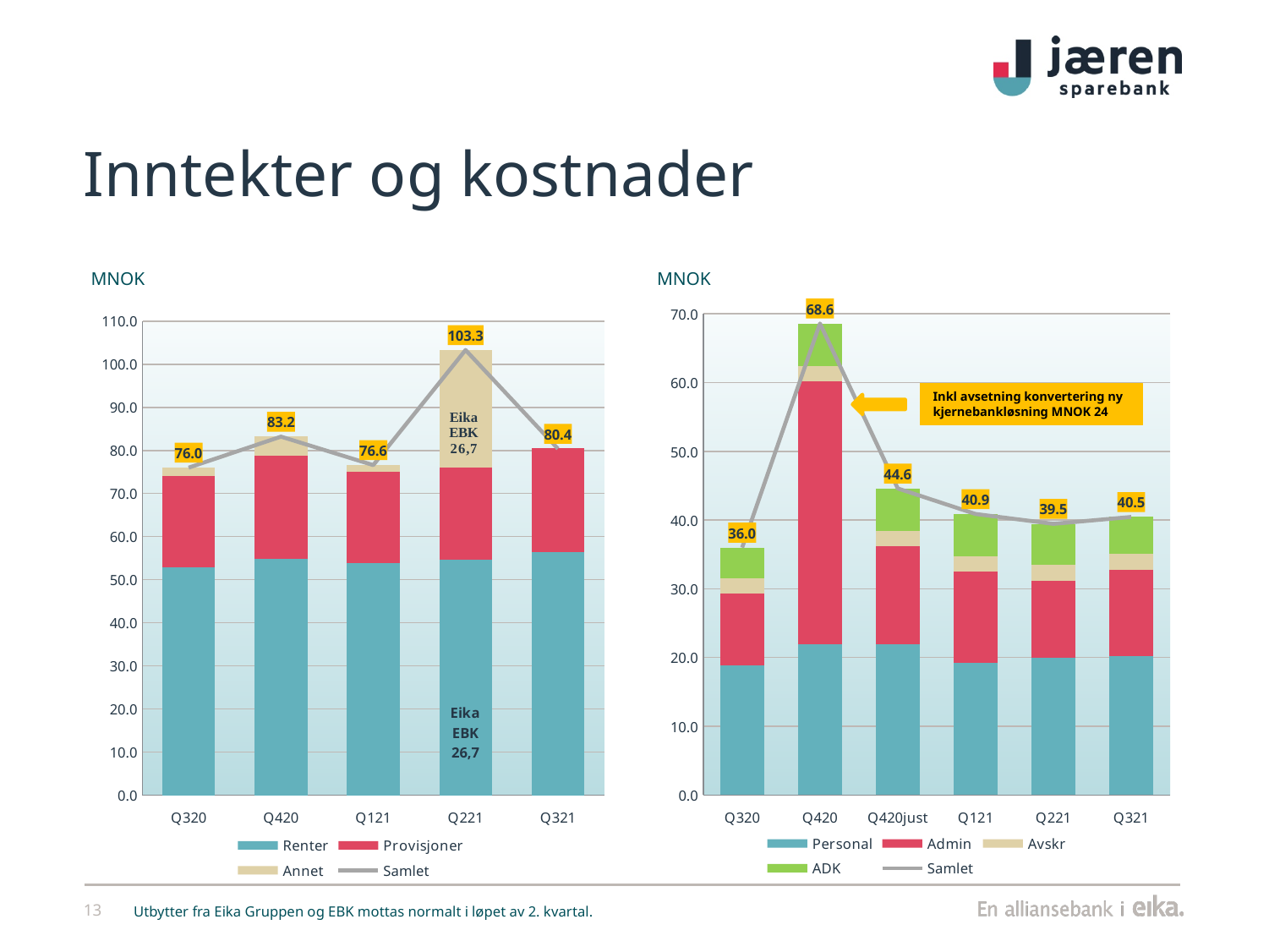
In the left chart, which quarter has the lowest Samlet value? Q320 In the right chart, what is the Samlet value for Q420? 68.6 In the right chart, is the Samlet value for Q221 larger or smaller than the Samlet value for Q420just? smaller What kind of chart is the right chart? Stacked bar chart with a line In the left chart, what is the Samlet value for Q221? 103.3 In the left chart, what is the difference between the Samlet values for Q221 and Q121? 26.7 In the left chart, how many quarters are shown on the x axis? 5 In the left chart, how many entries does the legend list? 4 In the left chart, which quarter has the highest Samlet value? Q221 In the right chart, what is the difference between the Samlet values for Q420 and Q320? 32.6 In the right chart, how many categories are shown on the x axis? 6 In the right chart, which quarter has the lowest Samlet value? Q320